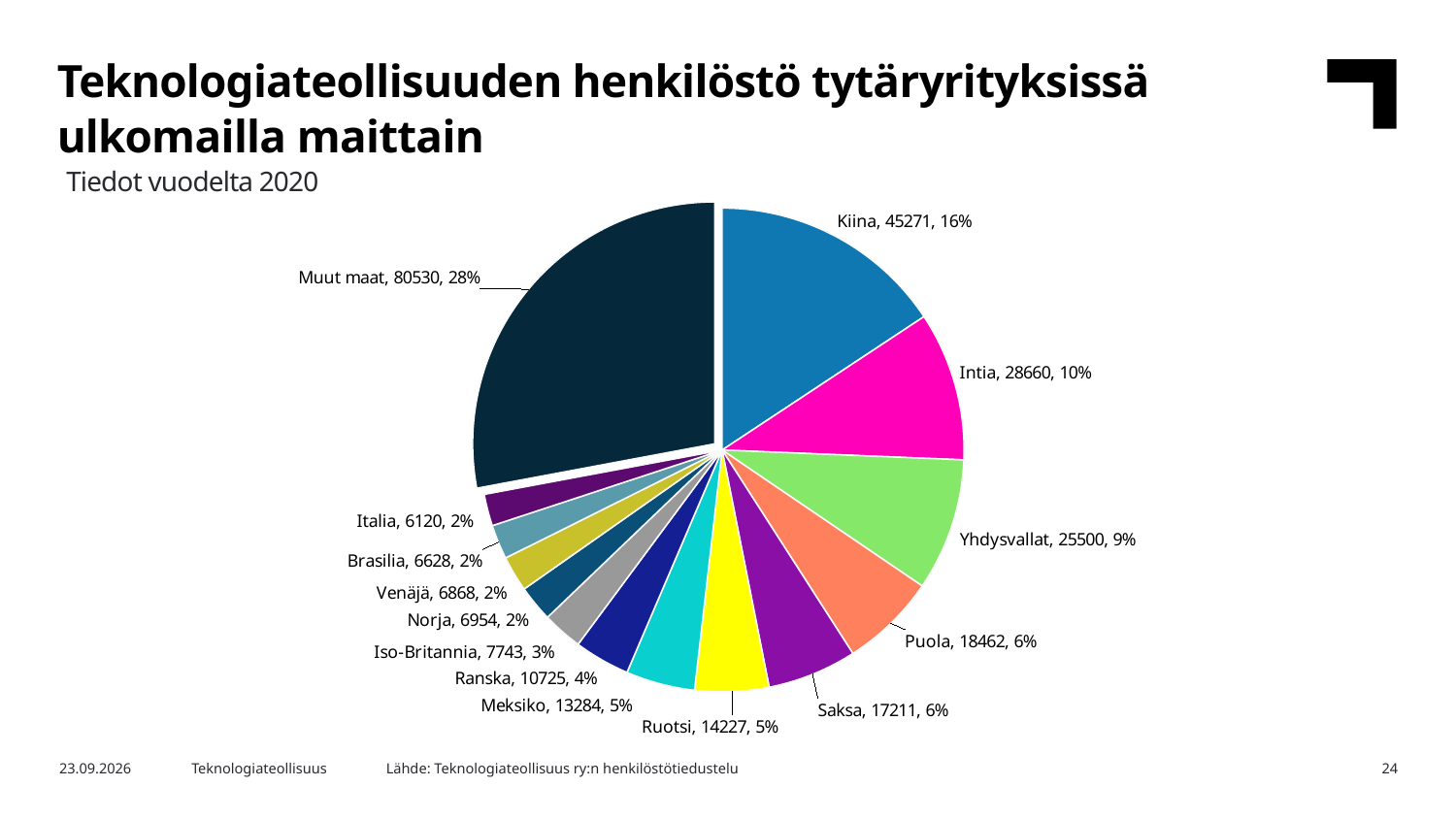
Which slice is the smallest in the pie chart? Italia Which slice is the largest in the pie chart? Muut maat What is the difference between the values for Kiina and Intia? 16611 What kind of chart is shown on the slide? Pie chart What share of the pie does Intia represent? 10% What is the value for Yhdysvallat? 25500 How many slices does the pie chart have? 14 What is the value for Ruotsi? 14227 Which has a larger value, Puola or Saksa? Puola What is the value for Kiina? 45271 What is the subtitle shown under the chart title? Tiedot vuodelta 2020 What share of the pie does Muut maat represent? 28%